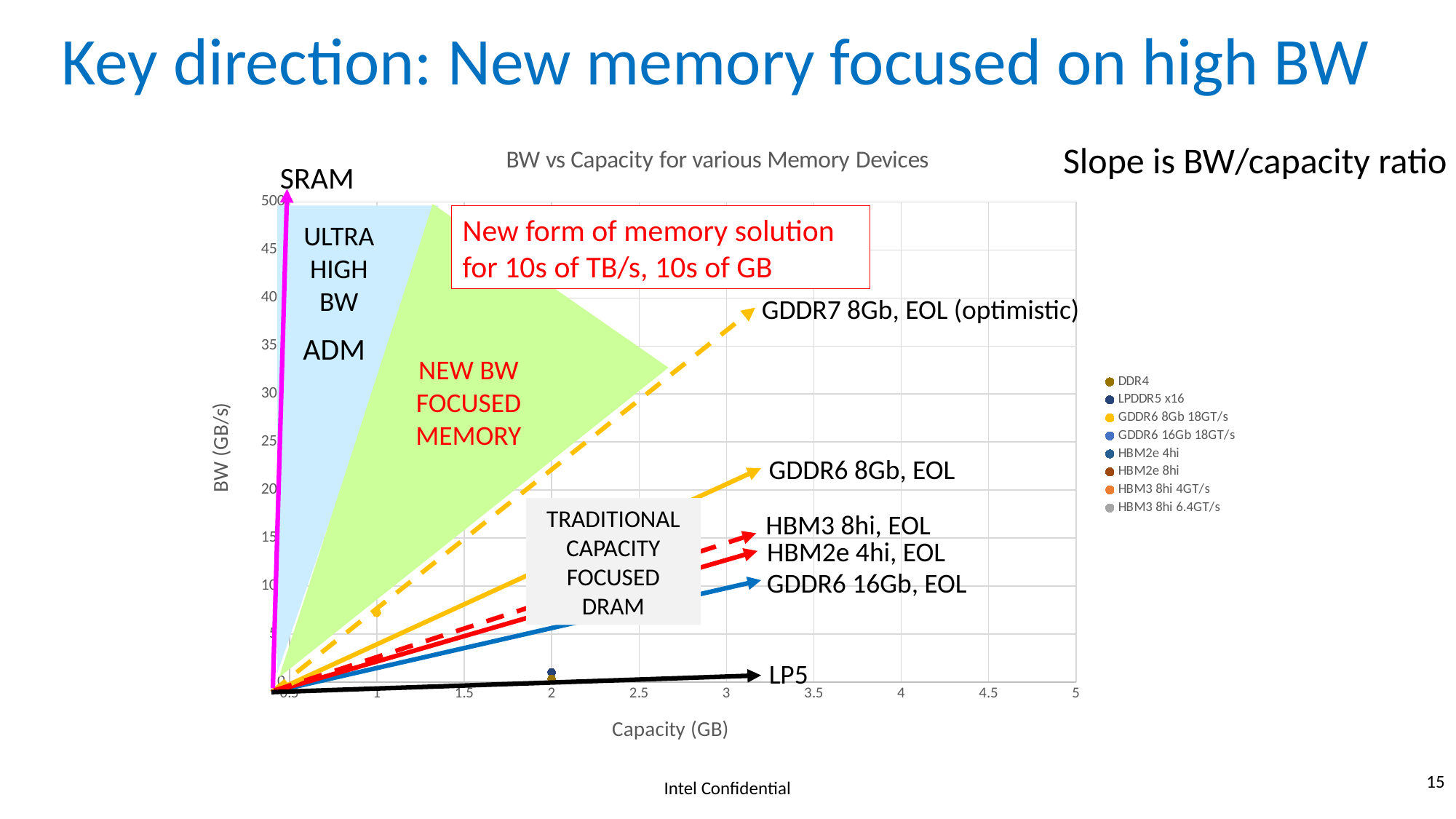
What is the label on the vertical axis of the chart? BW (GB/s) Which arrow reaches a higher BW value: the one labelled GDDR7 8Gb, EOL (optimistic) or the one labelled GDDR6 8Gb, EOL? GDDR7 8Gb, EOL (optimistic) What is the title of the chart? BW vs Capacity for various Memory Devices Is the BW value at the tip of the LP5 arrow greater or less than 50? less Is the BW value at the tip of the GDDR6 16Gb, EOL arrow greater or less than 150? less Of the arrows labelled GDDR7 8Gb, GDDR6 8Gb, HBM3 8hi, HBM2e 4hi, GDDR6 16Gb and LP5, which reaches the highest BW value? GDDR7 8Gb, EOL (optimistic) How many series does the chart legend list? 8 What kind of chart is shown on the slide? scatter chart Is the BW value at the tip of the GDDR6 8Gb, EOL arrow greater or less than 250? less Of the arrows labelled GDDR7 8Gb, GDDR6 8Gb, HBM3 8hi, HBM2e 4hi, GDDR6 16Gb and LP5, which reaches the lowest BW value? LP5 Which arrow reaches a higher BW value: the one labelled HBM3 8hi, EOL or the one labelled GDDR6 16Gb, EOL? HBM3 8hi, EOL